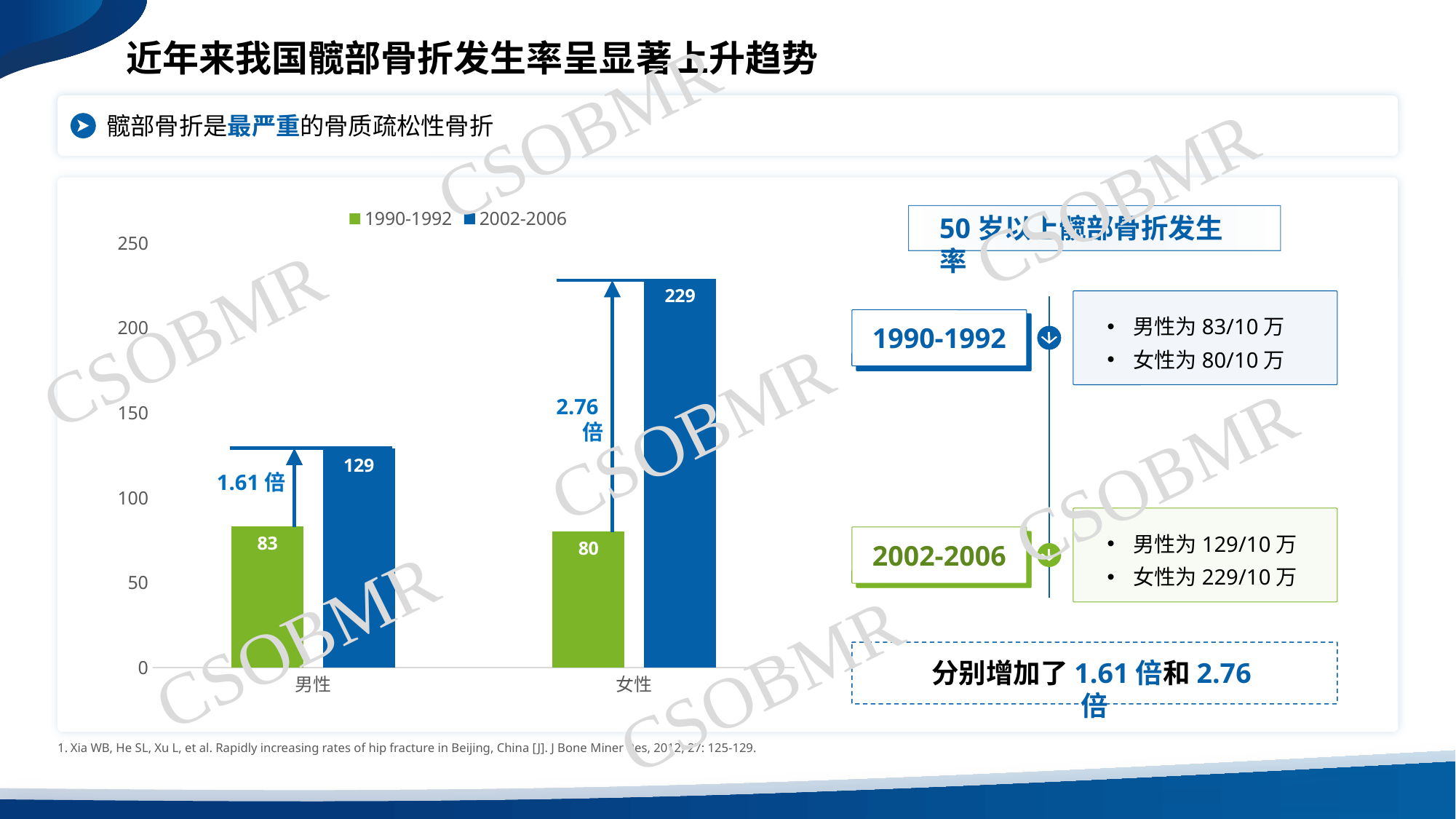
What is the value for 男性 in the 1990-1992 series? 83 Which category has the lowest value in the 1990-1992 series? 女性 What kind of chart is shown on the slide? Bar chart How many categories are shown on the x axis? 2 What is the value for 男性 in the 2002-2006 series? 129 Which is larger for 男性: the 1990-1992 value or the 2002-2006 value? 2002-2006 How many series does the legend list? 2 What is the value for 女性 in the 2002-2006 series? 229 What is the difference between the 2002-2006 and 1990-1992 values for 女性? 149 What is the value for 女性 in the 1990-1992 series? 80 What is the difference between the 2002-2006 and 1990-1992 values for 男性? 46 Which category has the highest value in the 2002-2006 series? 女性